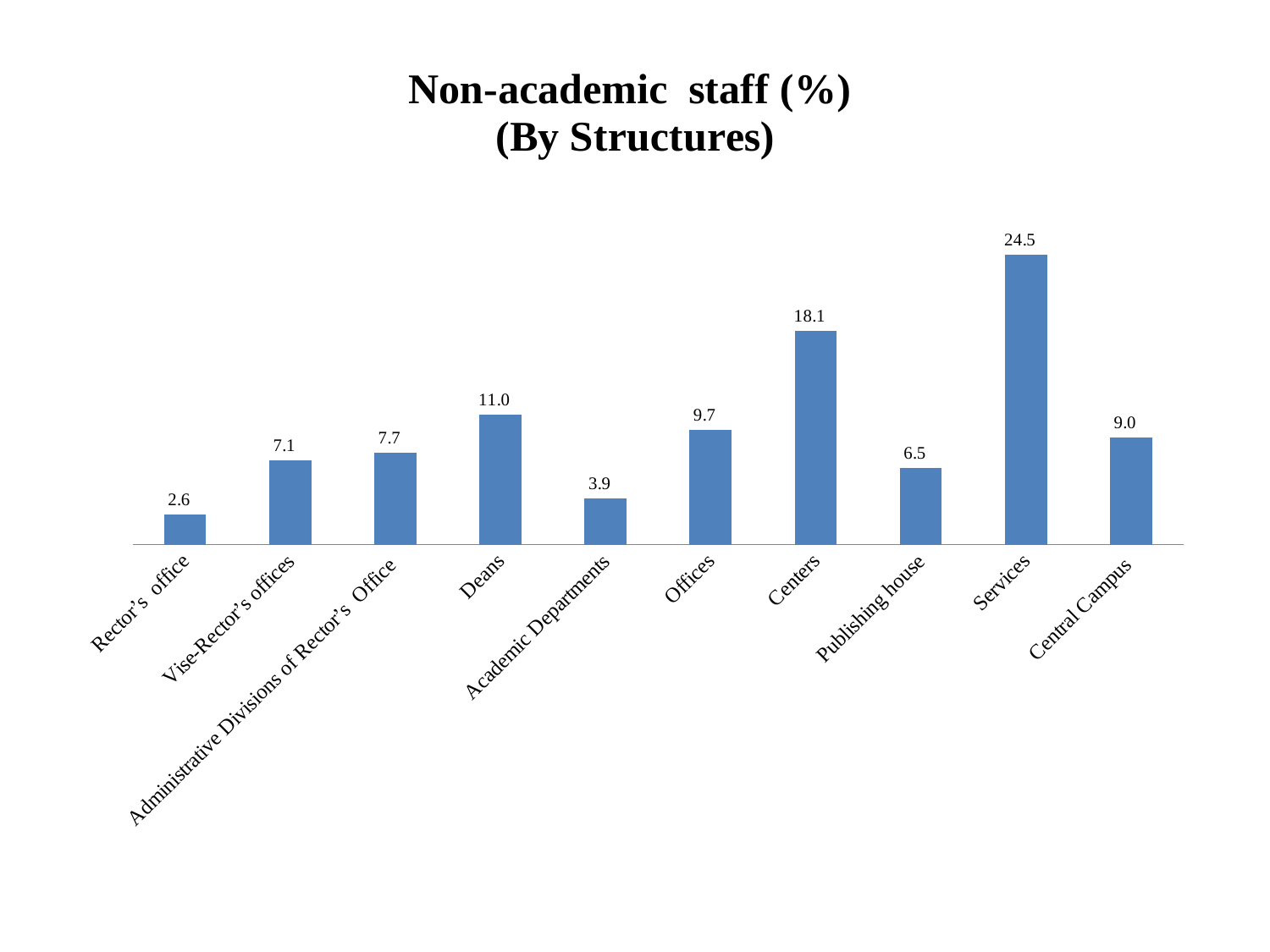
Which is larger, the value for Vise-Rector's offices or the value for Administrative Divisions of Rector's Office? Administrative Divisions of Rector's Office Which category has the lowest value? Rector's office What is the difference between the values for Deans and Offices? 1.3 What is the value for Publishing house? 6.5 What is the title of the chart? Non-academic staff (%) (By Structures) What is the difference between the values for Services and Centers? 6.4 What is the value for Services? 24.5 Which is larger, the value for Central Campus or the value for Publishing house? Central Campus What is the value for Academic Departments? 3.9 Which category has the highest value? Services How many categories are shown on the x axis? 10 What kind of chart is shown on the slide? Bar chart